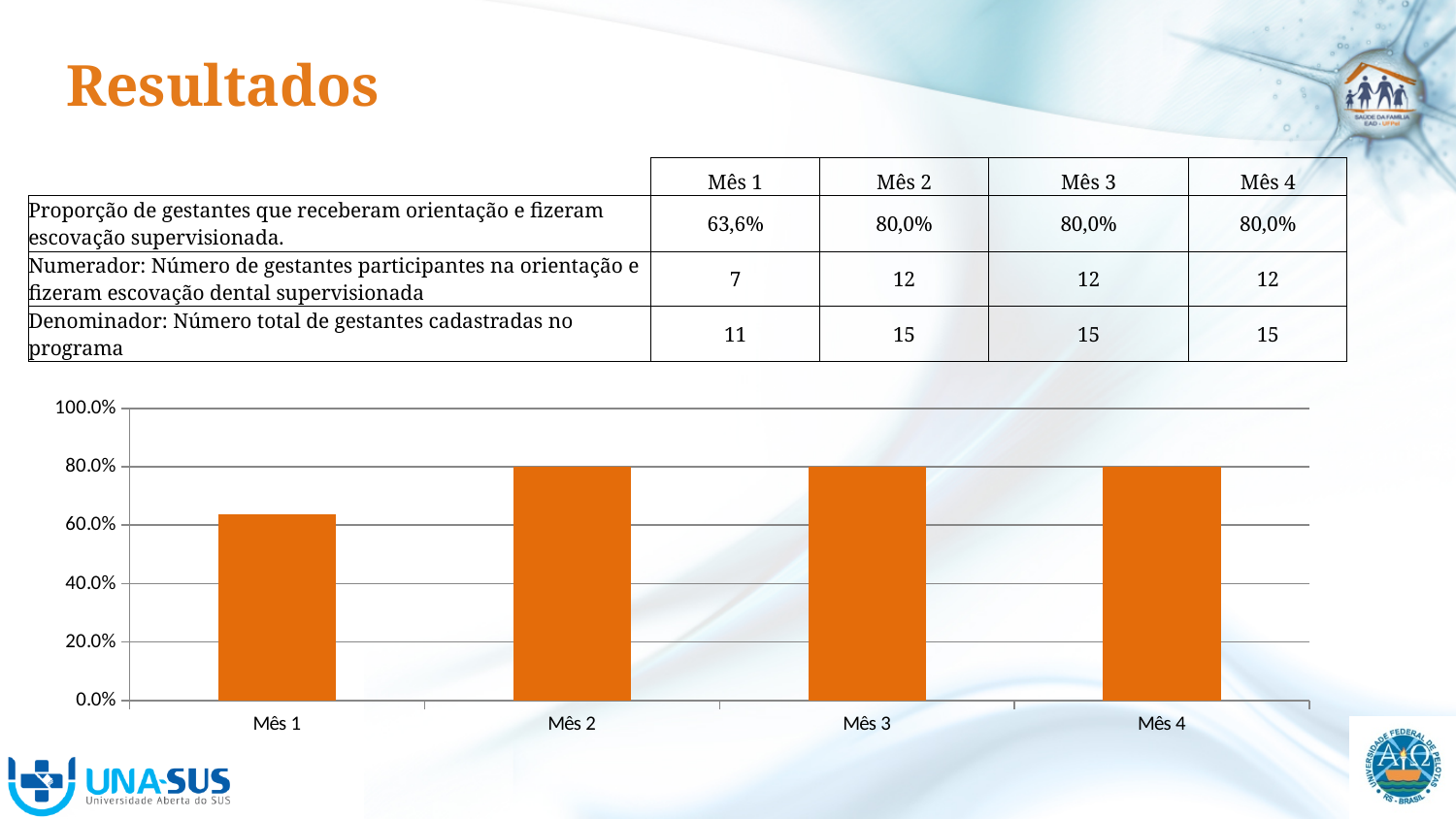
Do the values in the chart rise or fall from Mês 1 to Mês 2? rise Is the value for Mês 3 in the chart greater or less than 60.0%? greater How many categories (months) are plotted on the x axis of the chart? 4 What is the value of the bar for Mês 2 in the chart? 80.0% What colour are the bars in the chart? orange What is the value of the bar for Mês 4 in the chart? 80.0% Which bar is taller in the chart, Mês 1 or Mês 2? Mês 2 What is the highest value shown on the y axis of the chart? 100.0% Is the value for Mês 1 in the chart greater or less than 60.0%? greater Which month has the lowest bar in the chart? Mês 1 Is the value for Mês 1 in the chart greater or less than 80.0%? less What kind of chart is shown on the slide? bar chart